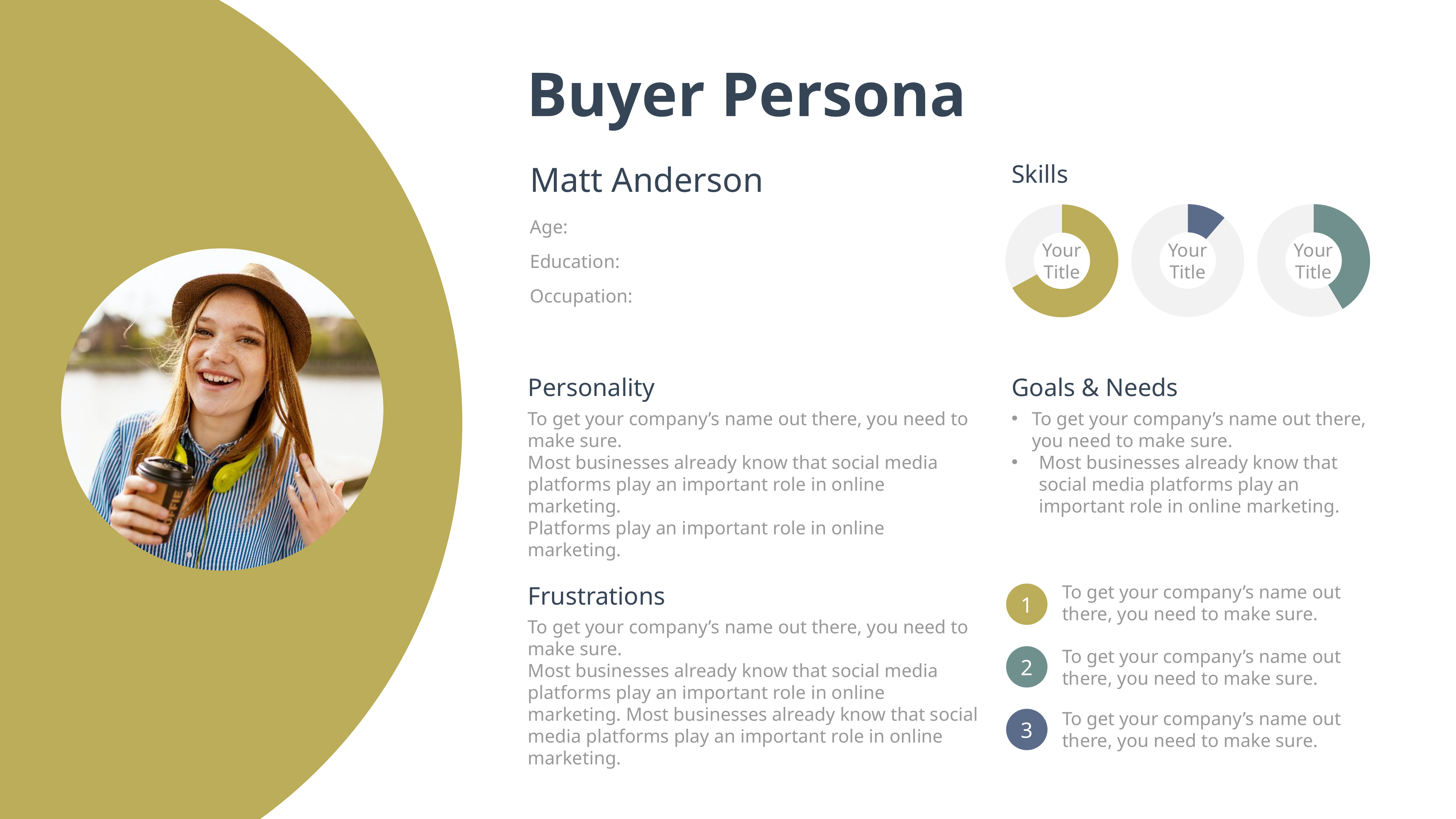
What label appears in the centre of each Skills donut chart? Your Title Among the three Skills donut charts, which one (left, middle or right) has the smallest filled portion? Middle What kind of charts are shown under the Skills heading? Donut charts In the Skills section, is the filled portion of the left donut chart larger or smaller than that of the middle donut chart? Larger In the Skills section, is the filled portion of the left donut chart larger or smaller than that of the right donut chart? Larger How many donut charts are shown under the Skills heading? 3 What colour is the filled portion of the middle Skills donut chart? Dark blue In the Skills section, is the filled portion of the right donut chart larger or smaller than that of the middle donut chart? Larger Among the three Skills donut charts, which one (left, middle or right) has the largest filled portion? Left